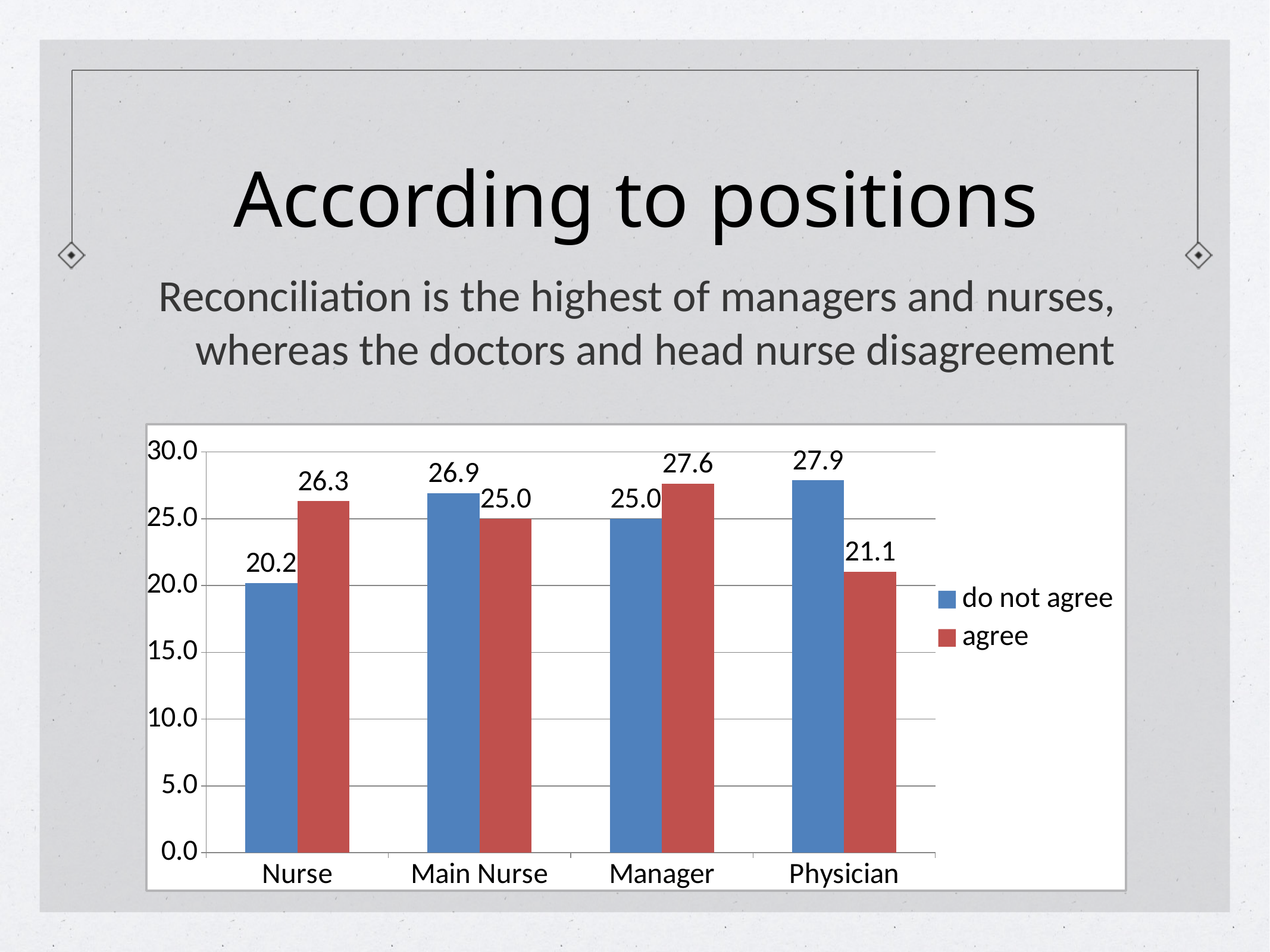
What is the 'agree' value for Manager? 27.6 What is the difference between the 'agree' and 'do not agree' values for Nurse? 6.1 What is the 'agree' value for Physician? 21.1 What is the 'do not agree' value for Nurse? 20.2 For Physician, which is larger: 'agree' or 'do not agree'? do not agree How many series does the legend list? 2 What kind of chart is shown on the slide? bar chart What is the 'do not agree' value for Main Nurse? 26.9 Which position has the lowest 'do not agree' value? Nurse Which position has the lowest 'agree' value? Physician How many positions are shown on the x axis? 4 Which position has the highest 'do not agree' value? Physician